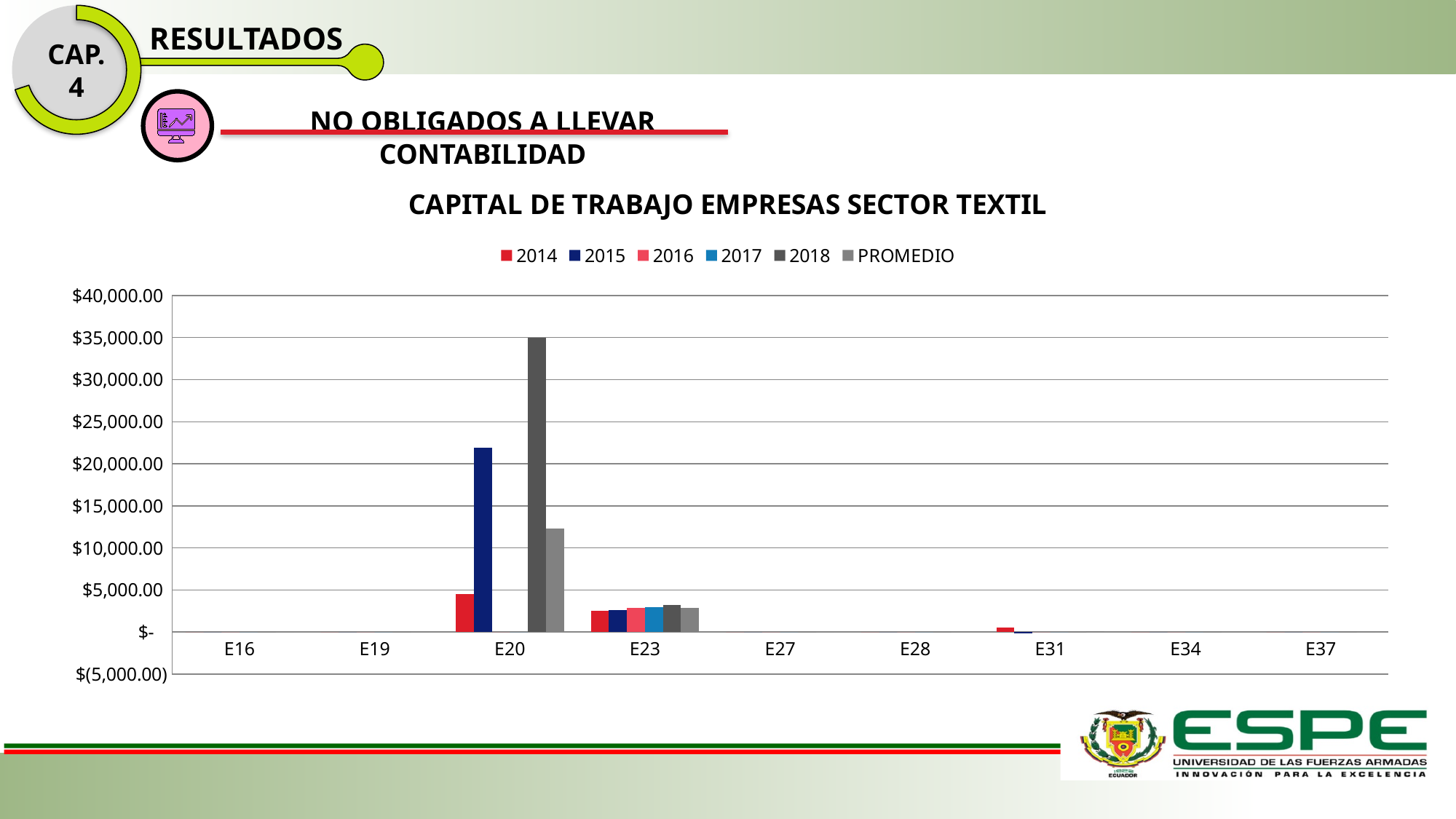
Is the 2014 value for E20 greater or less than $5,000.00? less Which series has the highest value for E20? 2018 What is the title of the chart? CAPITAL DE TRABAJO EMPRESAS SECTOR TEXTIL Is the 2018 value for E20 greater or less than $30,000.00? greater What type of chart is shown on the slide? bar chart For E20, which is larger: the 2014 value or the 2015 value? 2015 How many series does the legend list? 6 Which category has the tallest bar in the chart? E20 How many categories are shown on the x axis? 9 Is the PROMEDIO value for E20 greater or less than $15,000.00? less For E20, which is larger: the 2015 value or the 2018 value? 2018